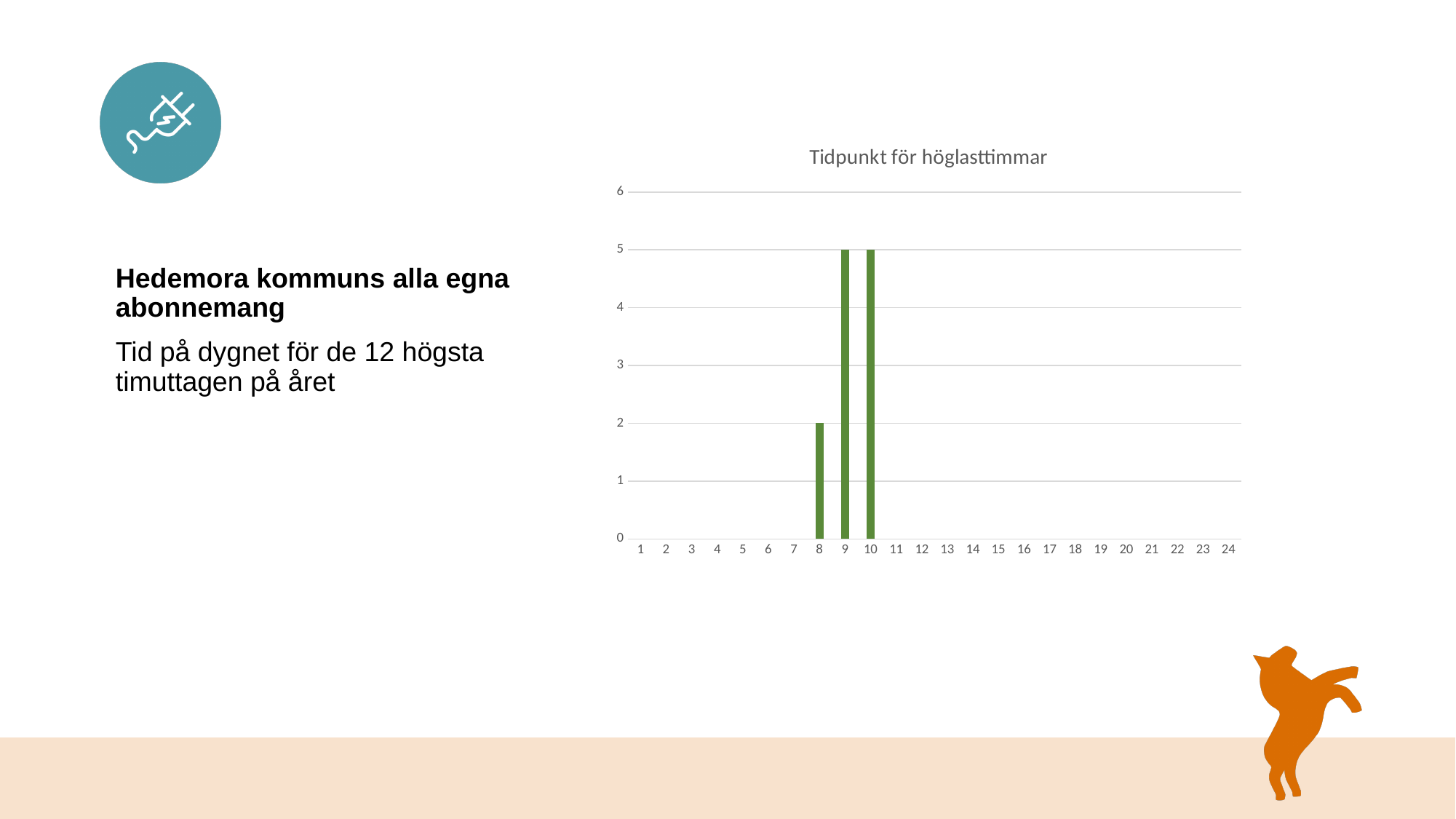
Is the value for hour 8 greater or less than 3? less What is the value for hour 10 in the chart? 5 Is the value for hour 9 greater or less than 4? greater What kind of chart is shown on the slide? bar chart What is the title of the chart? Tidpunkt för höglasttimmar What is the difference between the value for hour 10 and the value for hour 8? 3 Which is larger, the value for hour 9 or the value for hour 8? hour 9 What is the value for hour 9 in the chart? 5 How many hours are labelled along the x axis of the chart? 24 How many hours have a non-zero bar in the chart? 3 Which of the hours with a bar has the lowest value? 8 What is the value for hour 8 in the chart? 2